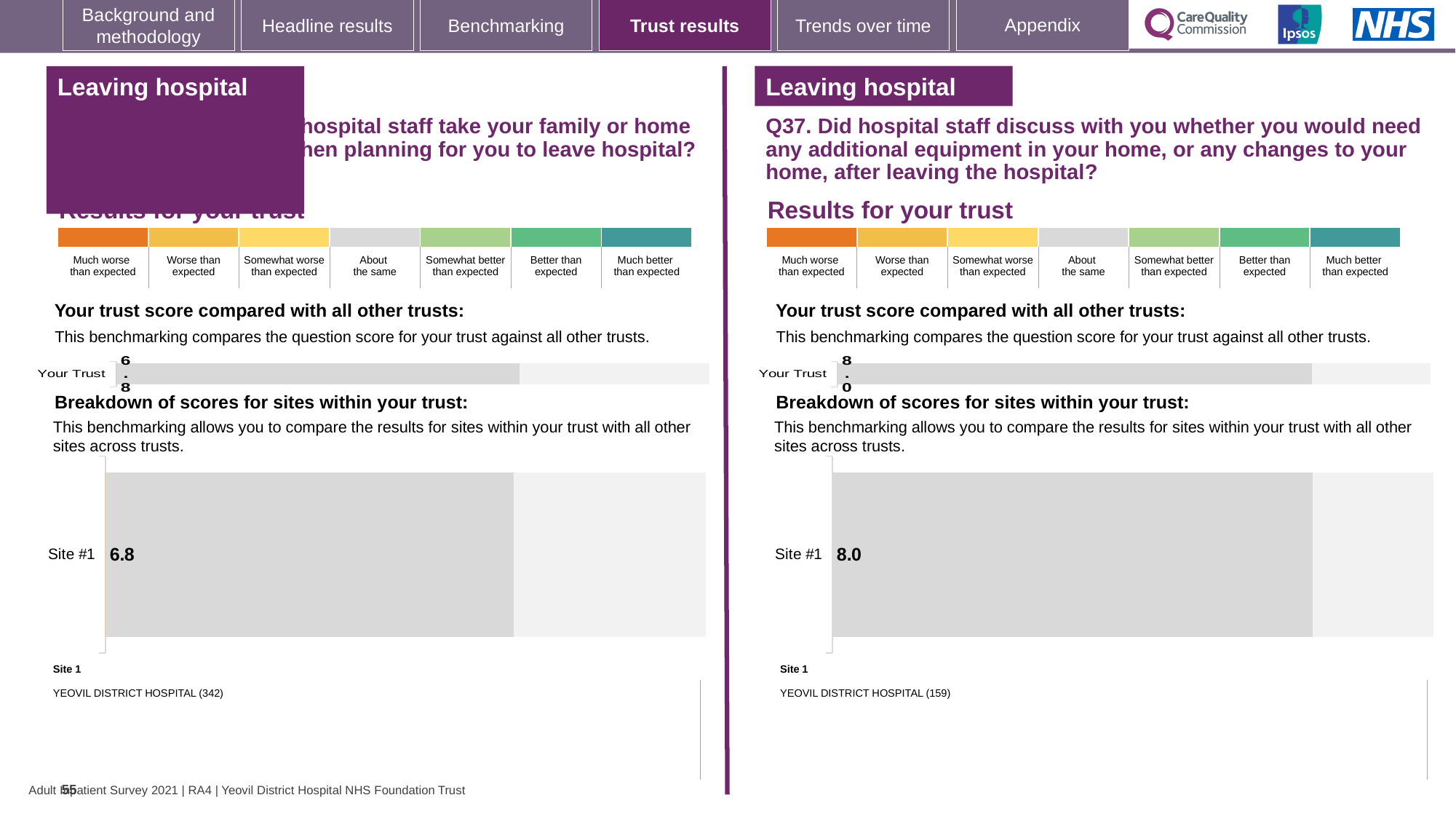
On the right-hand side (Q37), which hospital is listed as Site 1? YEOVIL DISTRICT HOSPITAL (159) On the left-hand chart, what is the score shown for Your Trust? 6.8 On the right-hand chart (Q37), what is the score shown for Your Trust? 8.0 On the left-hand breakdown chart, what is the score for Site #1? 6.8 What kind of chart is used to show the Site #1 score on the right-hand side (Q37)? Bar chart Which Site #1 score is larger: the one on the left-hand chart or the one on the right-hand chart (Q37)? The right-hand chart (Q37) On the left-hand side, which hospital is listed as Site 1? YEOVIL DISTRICT HOSPITAL (342) What is the difference between the Site #1 score on the right-hand chart (Q37) and the Site #1 score on the left-hand chart? 1.2 How many sites are shown in the left-hand breakdown chart? 1 How many sites are shown in the right-hand breakdown chart (Q37)? 1 On the right-hand breakdown chart (Q37), what is the score for Site #1? 8.0